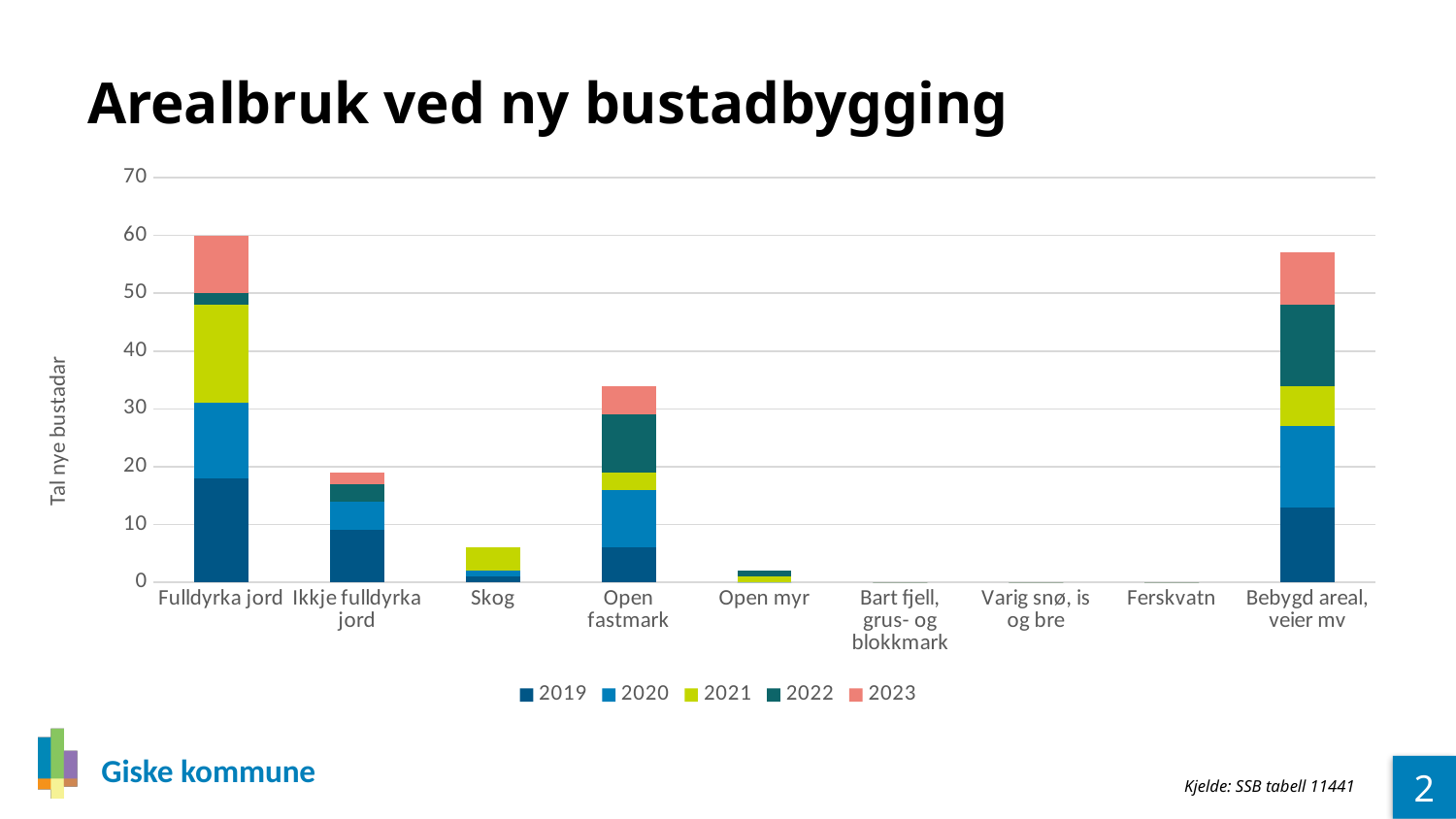
Which has the larger total, Fulldyrka jord or Open fastmark? Fulldyrka jord Is the total for Open fastmark greater or less than 40? less Is the total for Skog greater or less than 10? less Is the total for Bebygd areal, veier mv greater or less than 50? greater What is the title of the chart? Arealbruk ved ny bustadbygging How many series does the legend list? 5 How many categories are shown on the x axis? 9 Which category has the tallest stacked bar? Fulldyrka jord What kind of chart is shown on the slide? Stacked bar chart What is the label on the vertical axis? Tal nye bustadar How many categories show no visible bar at all? 3